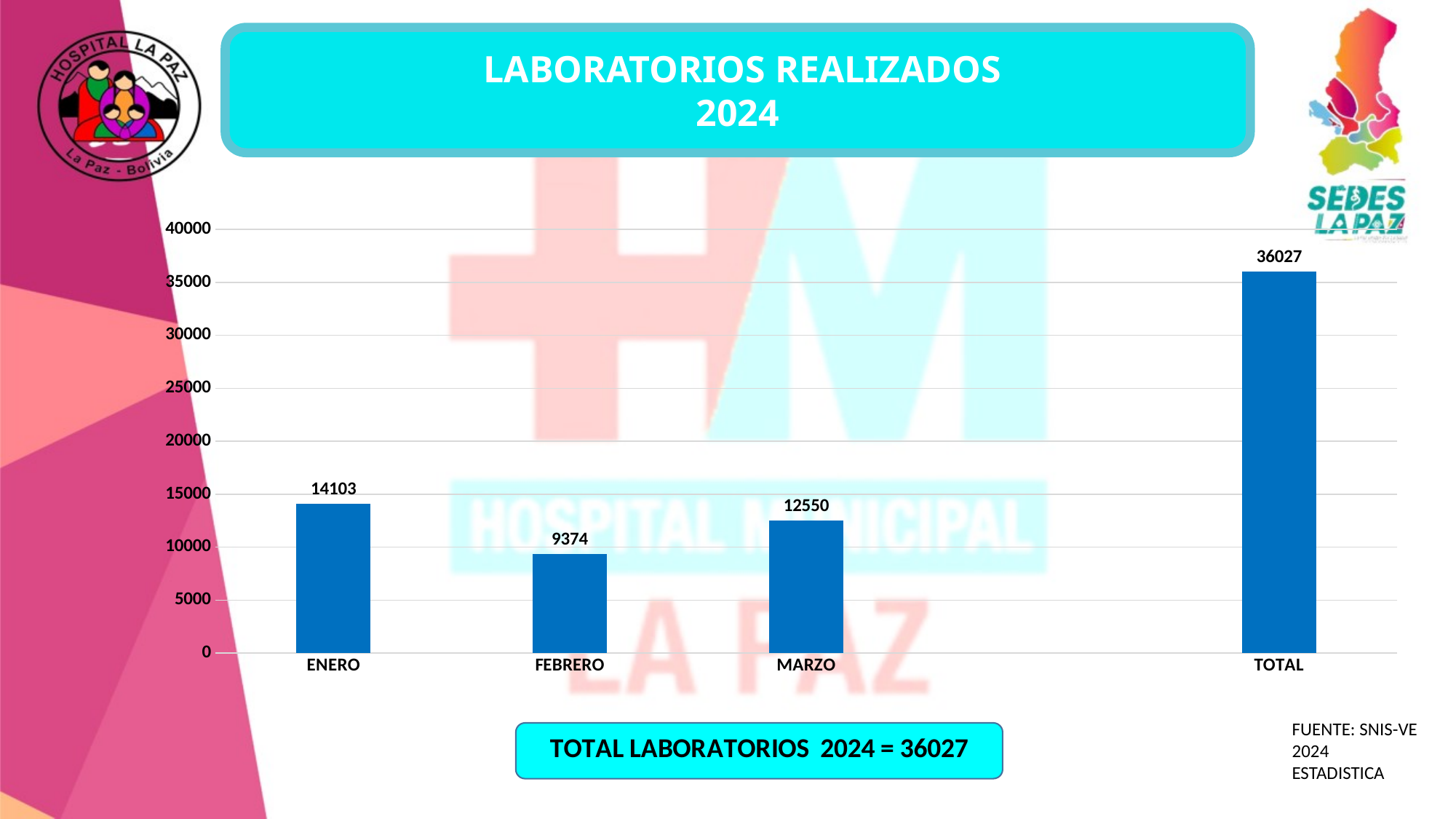
What is the value for ENERO? 14103 What is the value for TOTAL? 36027 What is the value for MARZO? 12550 What kind of chart is shown on the slide? bar chart Which category has the lowest value? FEBRERO Which is larger, the value for MARZO or the value for FEBRERO? MARZO How many bars are shown in the chart? 4 What is the title of the chart? LABORATORIOS REALIZADOS 2024 Among the months ENERO, FEBRERO and MARZO, which has the highest value? ENERO What is the value for FEBRERO? 9374 What is the difference between the values for ENERO and FEBRERO? 4729 What is the difference between the values for MARZO and FEBRERO? 3176